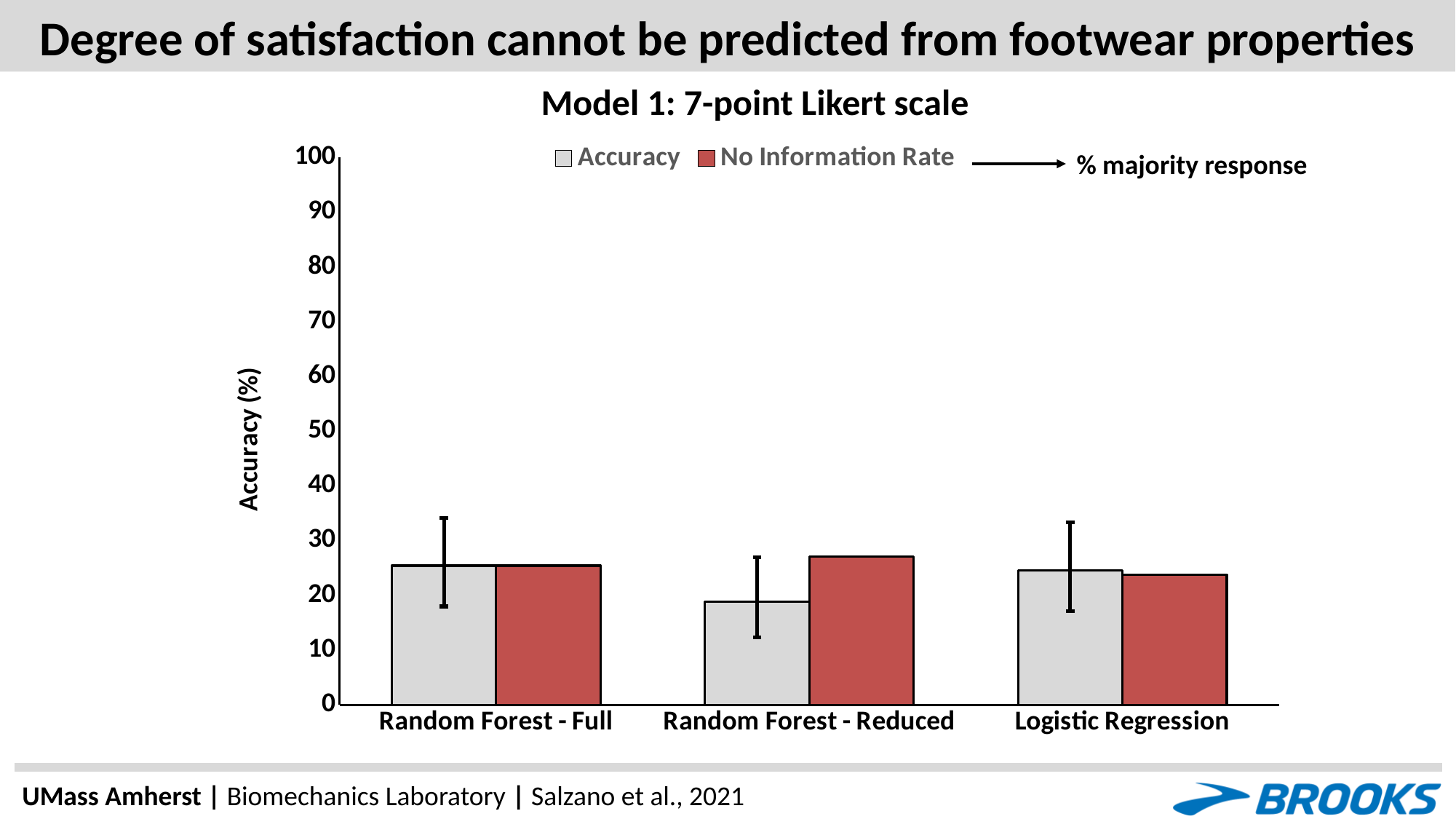
Is the Accuracy value for Random Forest - Reduced greater or less than 20? less Is the Accuracy value for Random Forest - Full greater or less than 40? less How many model categories are shown on the x axis? 3 How many series does the legend list? 2 Which category has the lowest Accuracy value? Random Forest - Reduced For Random Forest - Reduced, which is larger: Accuracy or No Information Rate? No Information Rate Is the Accuracy value for Logistic Regression greater or less than 10? greater What is the title of the chart? Model 1: 7-point Likert scale What is the label of the y axis? Accuracy (%) What kind of chart is shown on the slide? Bar chart Which category has the highest No Information Rate value? Random Forest - Reduced